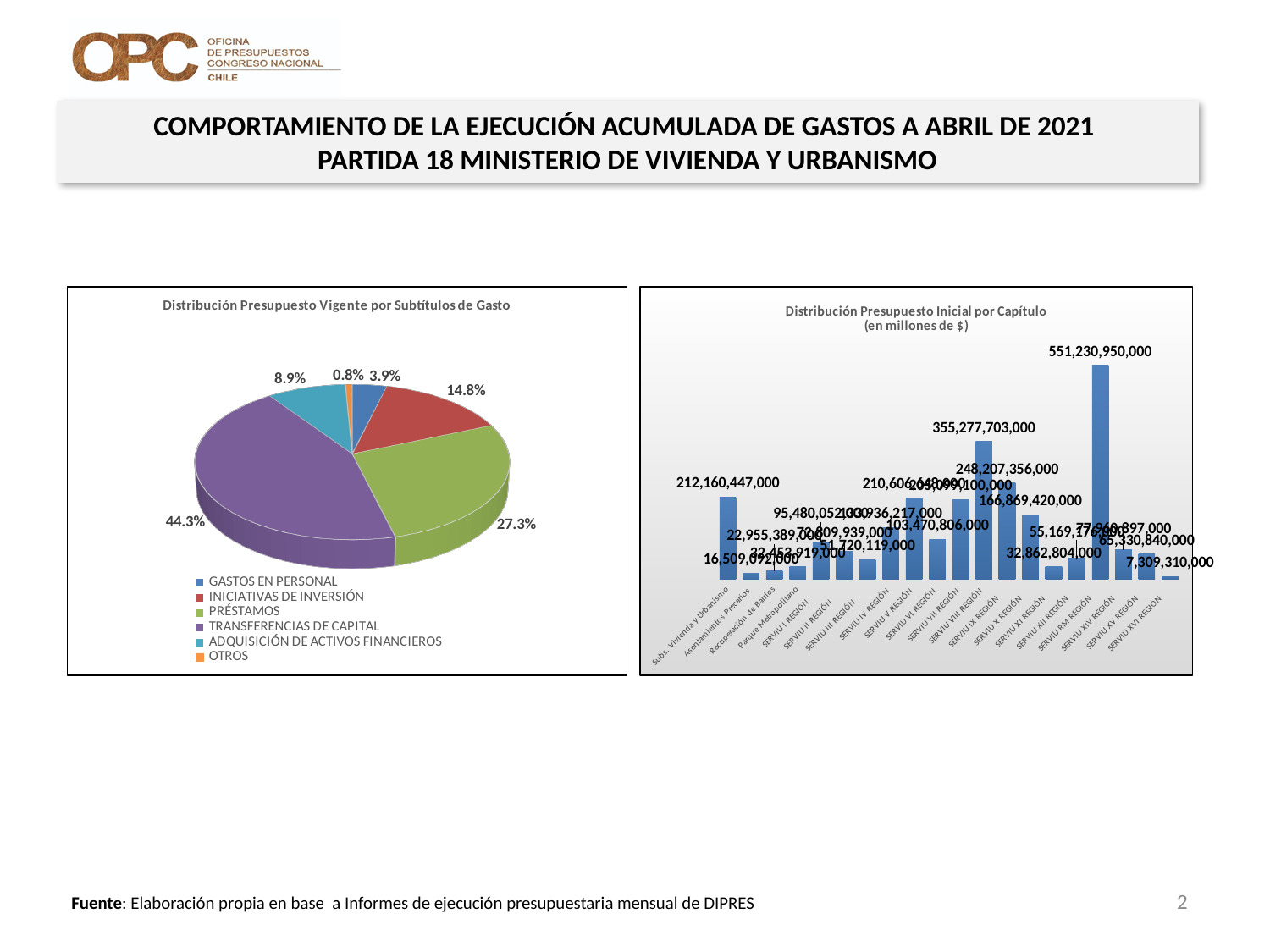
In the chart 'Distribución Presupuesto Inicial por Capítulo', which capítulo has the highest value? SERVIU RM REGIÓN In the pie chart 'Distribución Presupuesto Vigente por Subtítulos de Gasto', which category has the smallest share? OTROS In the pie chart 'Distribución Presupuesto Vigente por Subtítulos de Gasto', which is larger: INICIATIVAS DE INVERSIÓN or ADQUISICIÓN DE ACTIVOS FINANCIEROS? INICIATIVAS DE INVERSIÓN In the chart 'Distribución Presupuesto Inicial por Capítulo', which capítulo has the lowest value? SERVIU XVI REGIÓN In the pie chart 'Distribución Presupuesto Vigente por Subtítulos de Gasto', which category has the largest share? TRANSFERENCIAS DE CAPITAL What kind of chart is 'Distribución Presupuesto Inicial por Capítulo'? Bar chart In the chart 'Distribución Presupuesto Inicial por Capítulo', what is the value for SERVIU VIII REGIÓN? 355,277,703,000 How many capítulos are shown in the chart 'Distribución Presupuesto Inicial por Capítulo'? 20 How many categories does the legend of the pie chart 'Distribución Presupuesto Vigente por Subtítulos de Gasto' list? 6 In the pie chart 'Distribución Presupuesto Vigente por Subtítulos de Gasto', what share does TRANSFERENCIAS DE CAPITAL have? 44.3% In the chart 'Distribución Presupuesto Inicial por Capítulo', what is the value for Asentamientos Precarios? 16,509,092,000 In the pie chart 'Distribución Presupuesto Vigente por Subtítulos de Gasto', what share does PRÉSTAMOS have? 27.3%